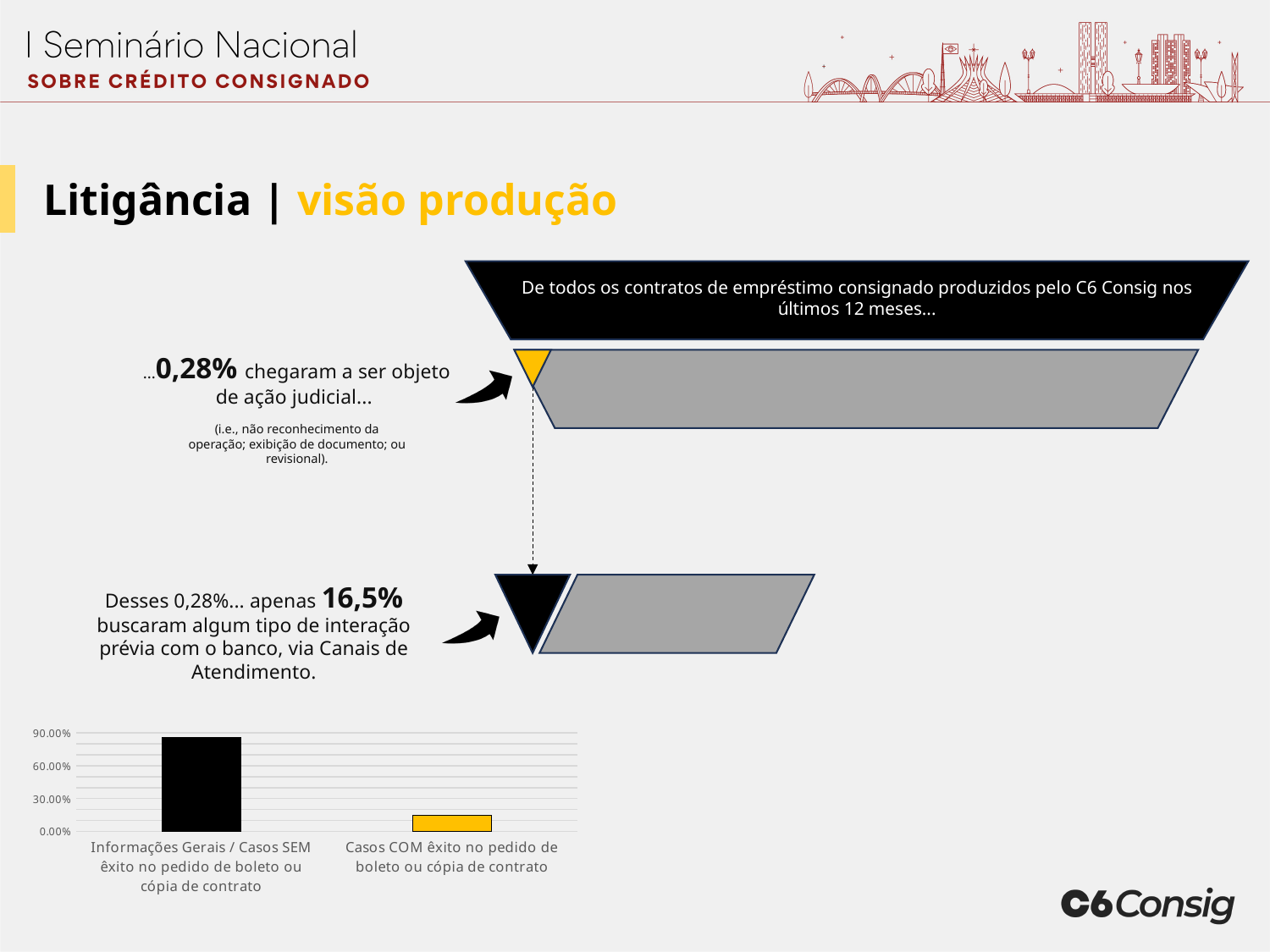
In the bar chart, do the values rise or fall from the left category to the right category? fall What kind of chart is shown at the bottom of the slide? bar chart What colour is the bar for 'Casos COM êxito no pedido de boleto ou cópia de contrato' in the bar chart? yellow In the bar chart, is the value for 'Informações Gerais / Casos SEM êxito no pedido de boleto ou cópia de contrato' greater or less than 90.00%? less In the bar chart, which is larger: the value for 'Informações Gerais / Casos SEM êxito no pedido de boleto ou cópia de contrato' or the value for 'Casos COM êxito no pedido de boleto ou cópia de contrato'? Informações Gerais / Casos SEM êxito no pedido de boleto ou cópia de contrato In the bar chart, which category has the lowest value? Casos COM êxito no pedido de boleto ou cópia de contrato In the bar chart, which category has the highest value? Informações Gerais / Casos SEM êxito no pedido de boleto ou cópia de contrato How many categories does the bar chart at the bottom of the slide show? 2 What is the highest tick label shown on the vertical axis of the bar chart? 90.00% In the bar chart, is the value for 'Casos COM êxito no pedido de boleto ou cópia de contrato' greater or less than 30.00%? less In the bar chart, is the value for 'Informações Gerais / Casos SEM êxito no pedido de boleto ou cópia de contrato' greater or less than 60.00%? greater